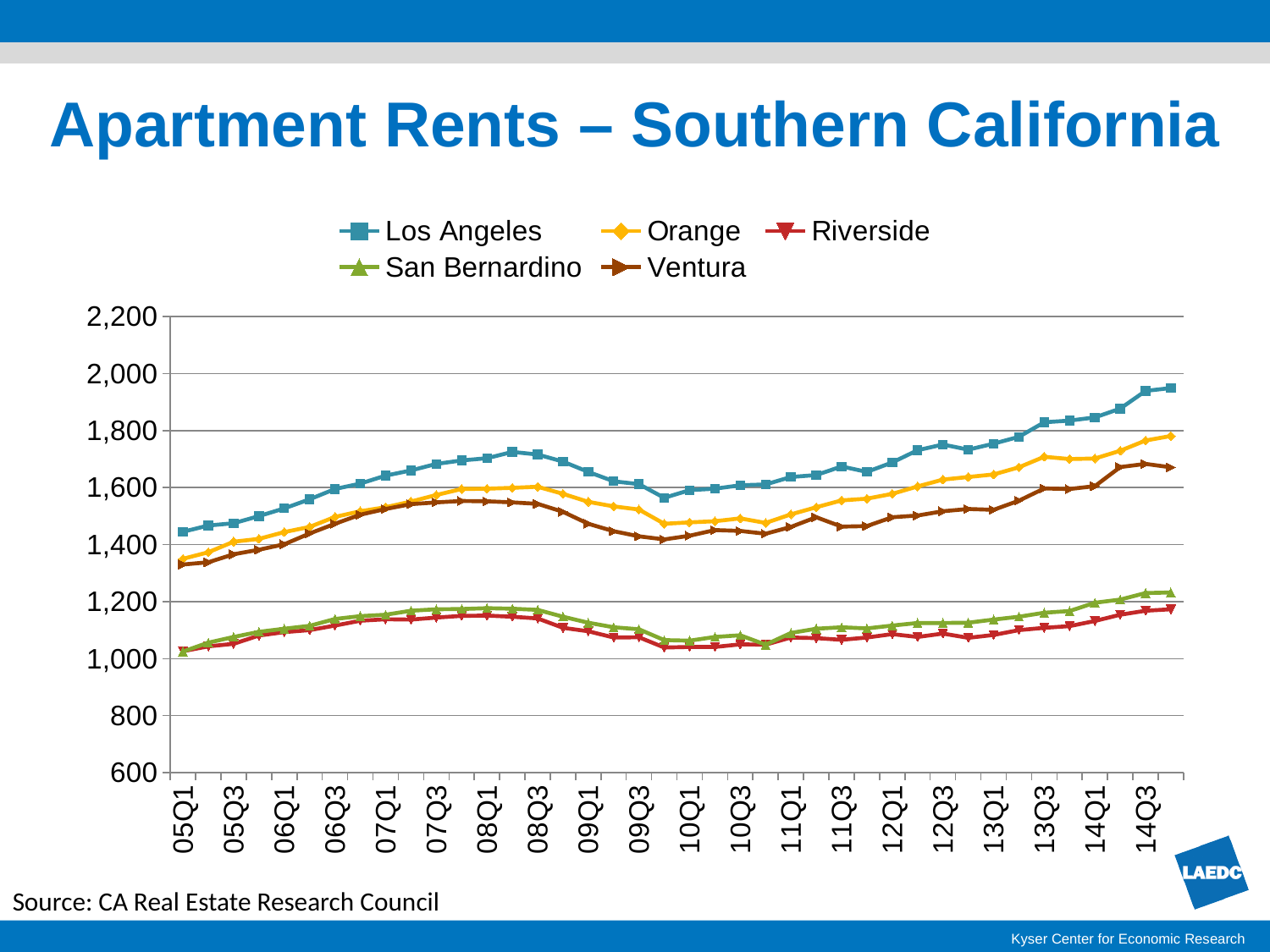
Is the value for Orange at 08Q3 greater or less than 1,400? greater Do the Los Angeles rents rise or fall between 08Q1 and 09Q3? fall How many series does the legend list? 5 Is the value for San Bernardino at 14Q3 greater or less than 1,400? less Is the value for Los Angeles at 14Q3 greater or less than 1,800? greater What is the title of the chart? Apartment Rents – Southern California Which series has the lowest value at 14Q3? Riverside What kind of chart is shown on the slide? line chart Which series has the highest apartment rents across the whole period? Los Angeles At 14Q3, which is larger: the value for Orange or the value for Ventura? Orange